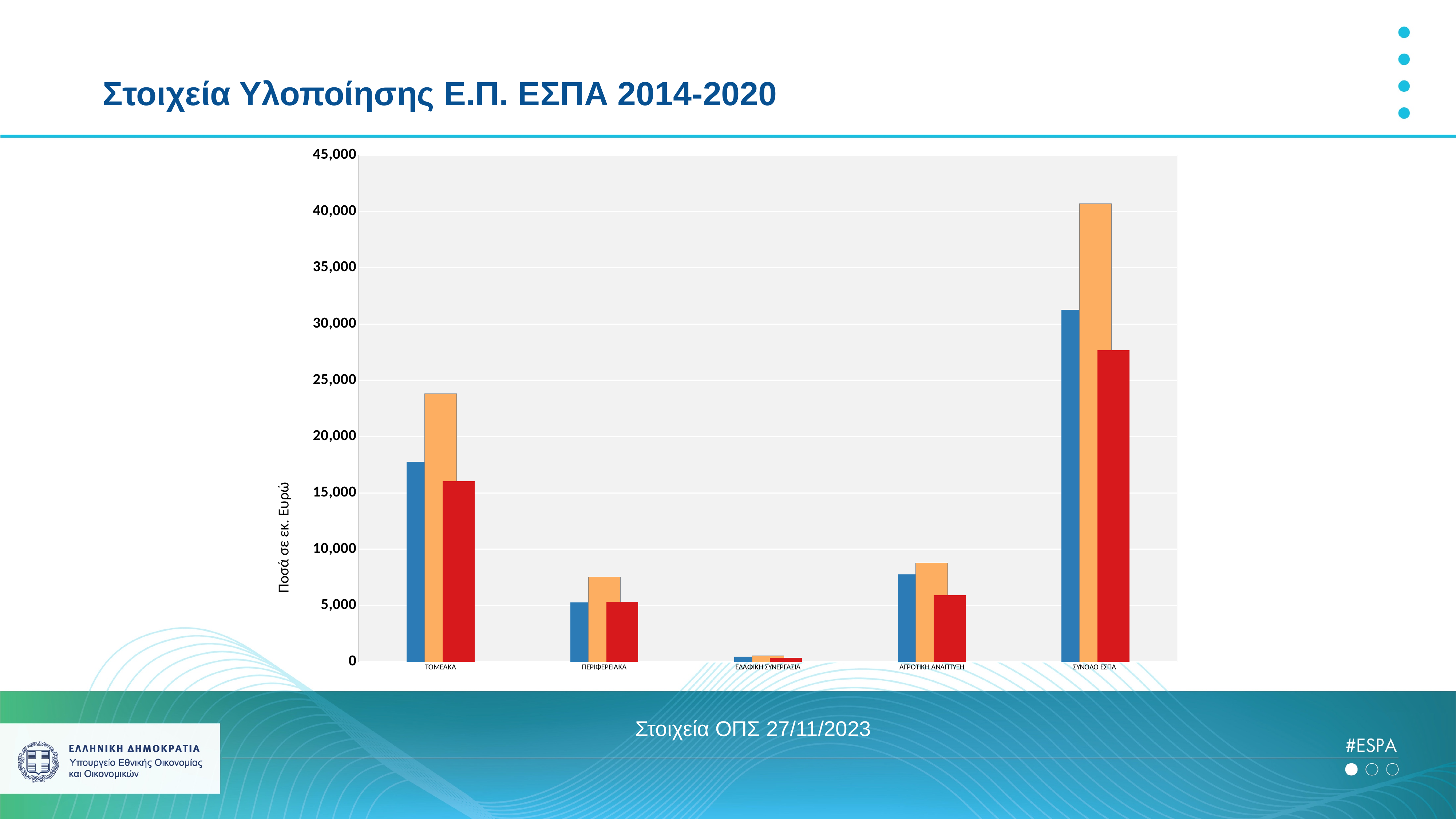
How many bars are plotted for each category in the chart? 3 What is the label of the vertical axis of the chart? Ποσά σε εκ. Ευρώ Is the value of the orange bar for ΑΓΡΟΤΙΚΗ ΑΝΑΠΤΥΞΗ greater or less than 10,000? less Is the value of the orange bar for ΤΟΜΕΑΚΑ greater or less than 25,000? less For ΤΟΜΕΑΚΑ, which is larger: the blue bar or the orange bar? The orange bar Which category has the tallest bars in the chart? ΣΥΝΟΛΟ ΕΣΠΑ What kind of chart is shown on the slide? Bar chart Is the value of the orange bar for ΣΥΝΟΛΟ ΕΣΠΑ greater or less than 40,000? greater Which category has the shortest bars in the chart? ΕΔΑΦΙΚΗ ΣΥΝΕΡΓΑΣΙΑ How many categories are shown on the x axis of the chart? 5